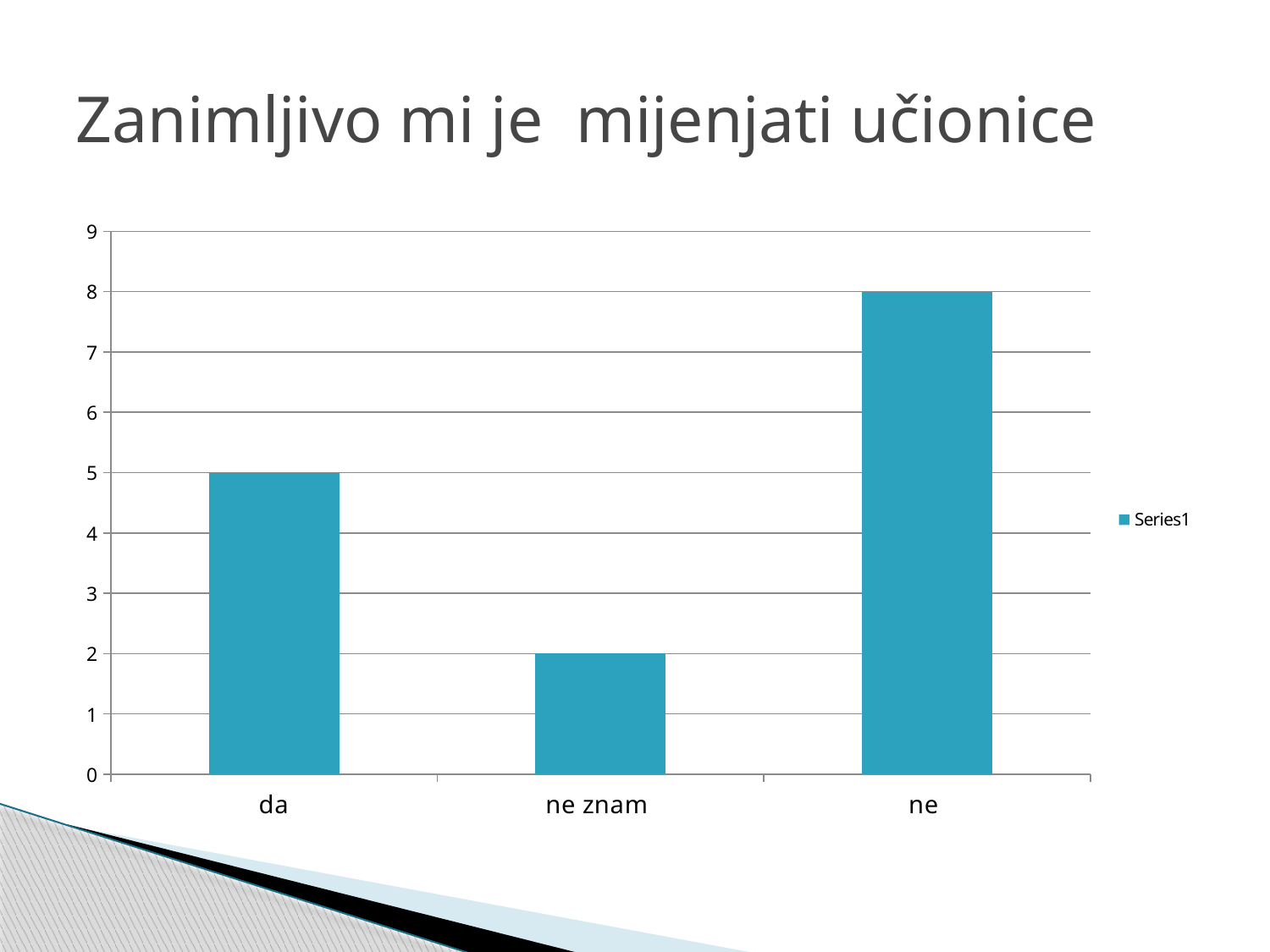
How many categories are shown on the x axis? 3 Which category has the lowest value? ne znam How many series does the legend list? 1 What is the value for "da"? 5 What is the title of the slide? Zanimljivo mi je mijenjati učionice What is the difference between the values for "ne" and "da"? 3 Which category has the highest value? ne Which is larger, the value for "da" or the value for "ne znam"? da What is the value for "ne"? 8 Is the value for "ne" greater or less than 6? greater What is the value for "ne znam"? 2 What kind of chart is shown on the slide? bar chart